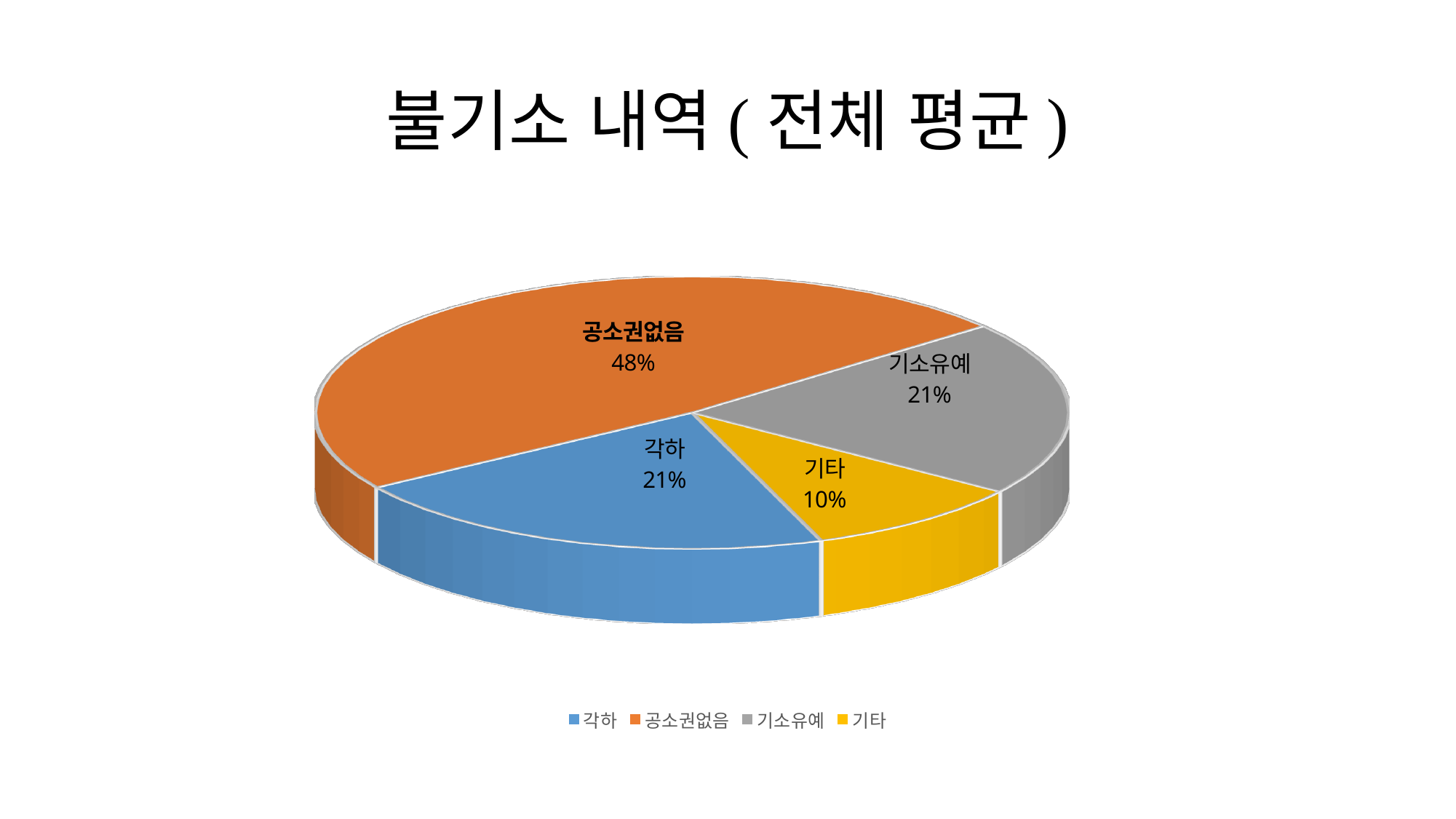
What colour is the slice for 기타? Yellow What is the title of the chart? 불기소 내역 ( 전체 평균 ) Which is larger, the share for 기소유예 or the share for 기타? 기소유예 What is the value shown for 기타? 10% What kind of chart is shown on the slide? Pie chart What is the value shown for 기소유예? 21% Which category has the smallest slice of the pie? 기타 What is the value shown for 각하? 21% What is the difference between the shares of 공소권없음 and 기타? 38% How many categories are shown in the pie chart? 4 What share of the pie does 공소권없음 represent? 48% Which category has the largest slice of the pie? 공소권없음